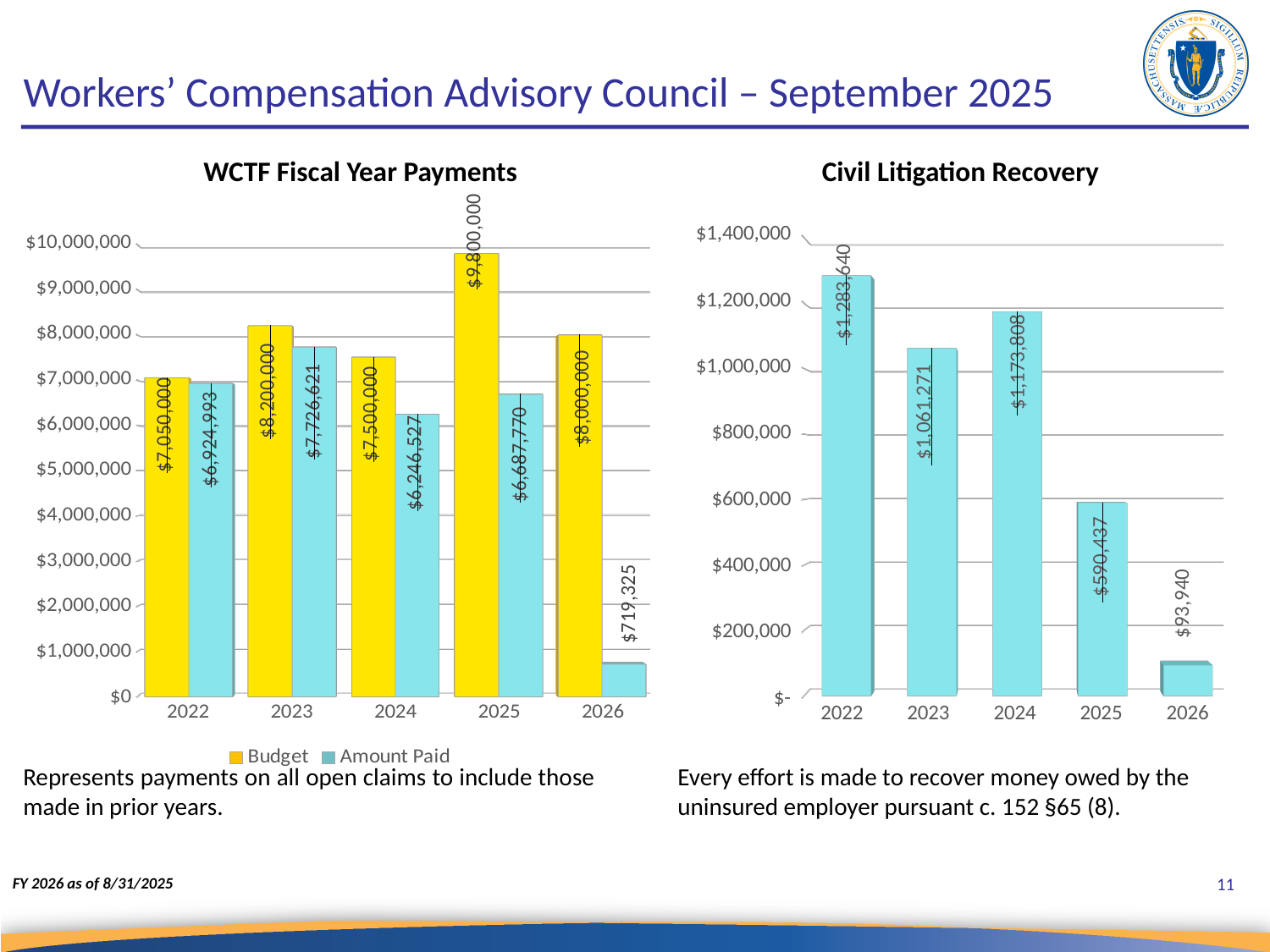
What kind of chart is the Civil Litigation Recovery chart? Bar chart In the WCTF Fiscal Year Payments chart, what is the difference between the Budget and the Amount Paid for 2023? $473,379 In the WCTF Fiscal Year Payments chart, what is the Budget value for 2025? $9,800,000 In the WCTF Fiscal Year Payments chart, is the Amount Paid for 2024 greater or less than $6,000,000? greater In the WCTF Fiscal Year Payments chart, what is the Amount Paid for 2024? $6,246,527 In the WCTF Fiscal Year Payments chart, which year has the highest Budget? 2025 In the Civil Litigation Recovery chart, what is the value for 2023? $1,061,271 In the WCTF Fiscal Year Payments chart, how many series does the legend list? 2 In the Civil Litigation Recovery chart, what is the difference between the 2022 and 2023 values? $222,369 In the Civil Litigation Recovery chart, which is larger, the value for 2023 or the value for 2024? 2024 In the Civil Litigation Recovery chart, which year has the highest value? 2022 In the WCTF Fiscal Year Payments chart, which year has the lowest Amount Paid? 2026